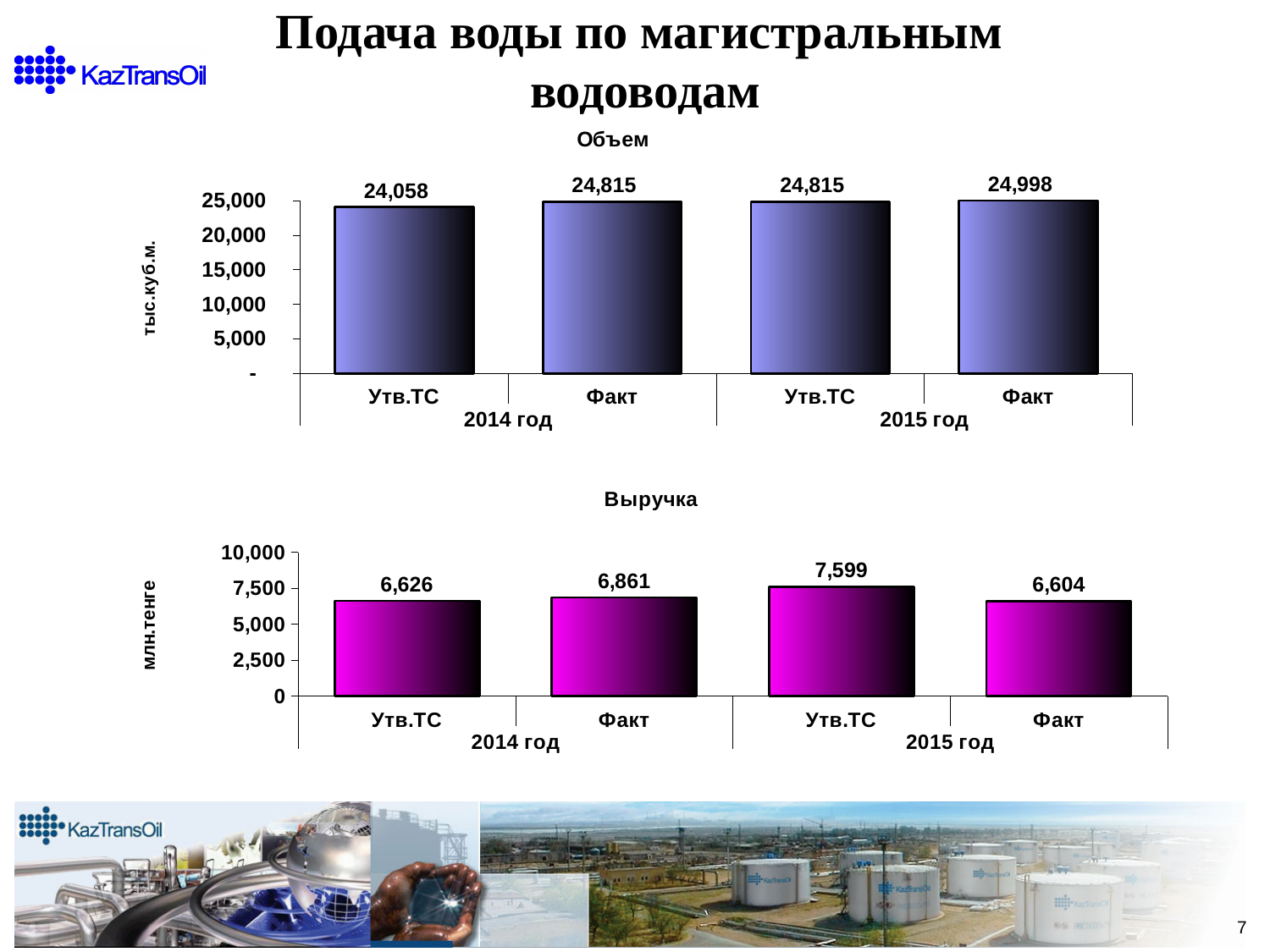
In the "Выручка" chart, which bar has the lowest value? Факт, 2015 год In the "Выручка" chart, what is the value for Факт in 2014 год? 6,861 In the "Объем" chart, which bar has the highest value? Факт, 2015 год In the "Объем" chart, what is the value for Утв.ТС in 2014 год? 24,058 In the "Выручка" chart, what is the value for Утв.ТС in 2015 год? 7,599 In the "Объем" chart, how many bars are plotted? 4 What type of chart is the "Объем" chart? Bar chart In the "Выручка" chart, what is the difference between Утв.ТС 2015 год and Факт 2015 год? 995 In the "Объем" chart, what is the value for Факт in 2015 год? 24,998 In the "Объем" chart, what is the difference between Факт 2014 год and Утв.ТС 2014 год? 757 In the "Выручка" chart, which is larger: Факт 2014 год or Утв.ТС 2014 год? Факт 2014 год What is the y-axis unit label of the "Выручка" chart? млн.тенге